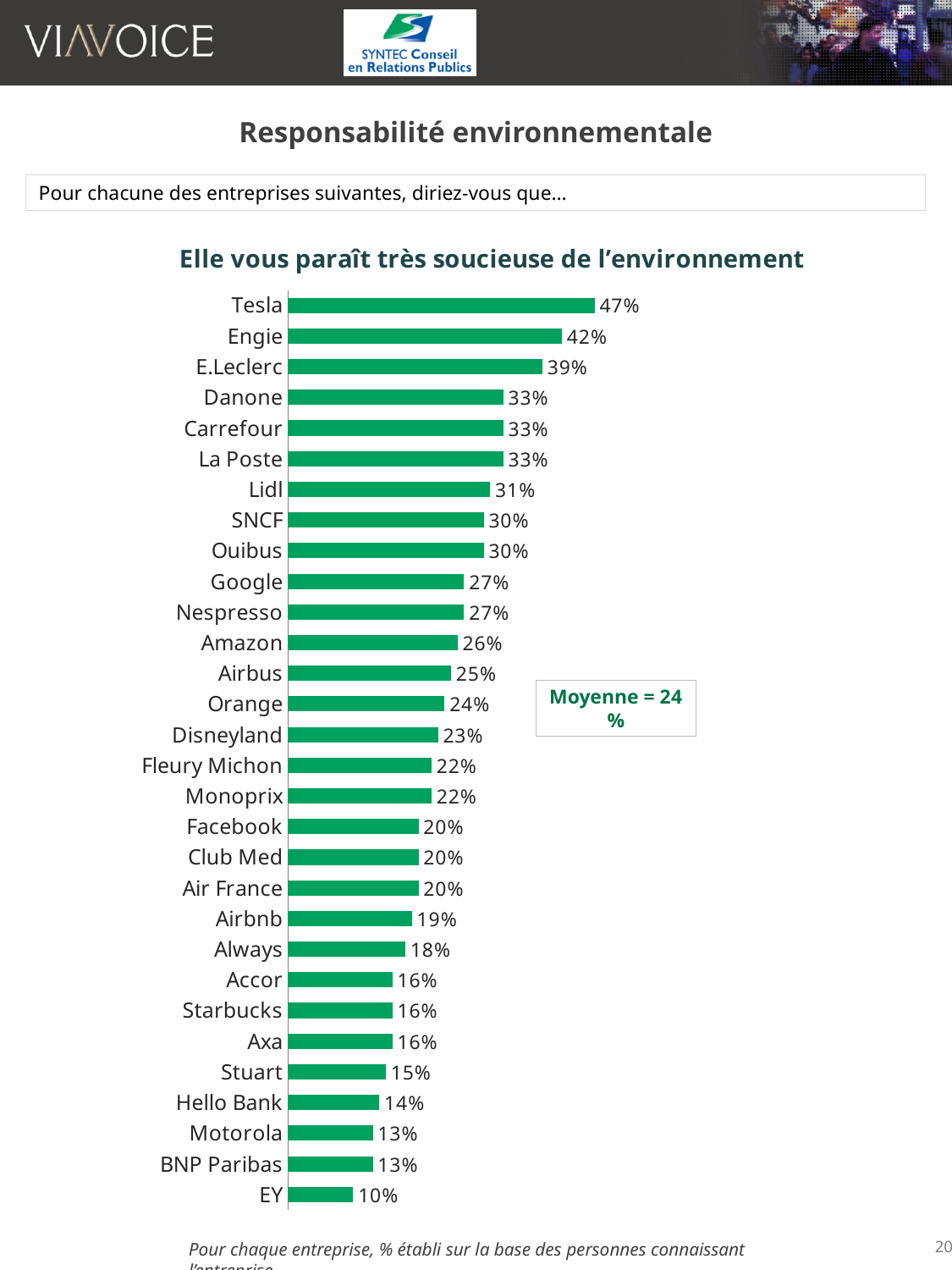
Which company has the lowest value? EY What type of chart is shown? Bar chart What is the difference between the values for Tesla and EY? 37% Which has a larger value, Lidl or Airbnb? Lidl Which company has the highest value? Tesla What is the value for Hello Bank? 14% How many companies are shown in the chart? 30 What is the title of the chart? Elle vous paraît très soucieuse de l'environnement What is the difference between the values for Engie and E.Leclerc? 3% What average value is indicated in the box next to the chart? 24 % What is the value for Nespresso? 27% What is the value for Tesla? 47%